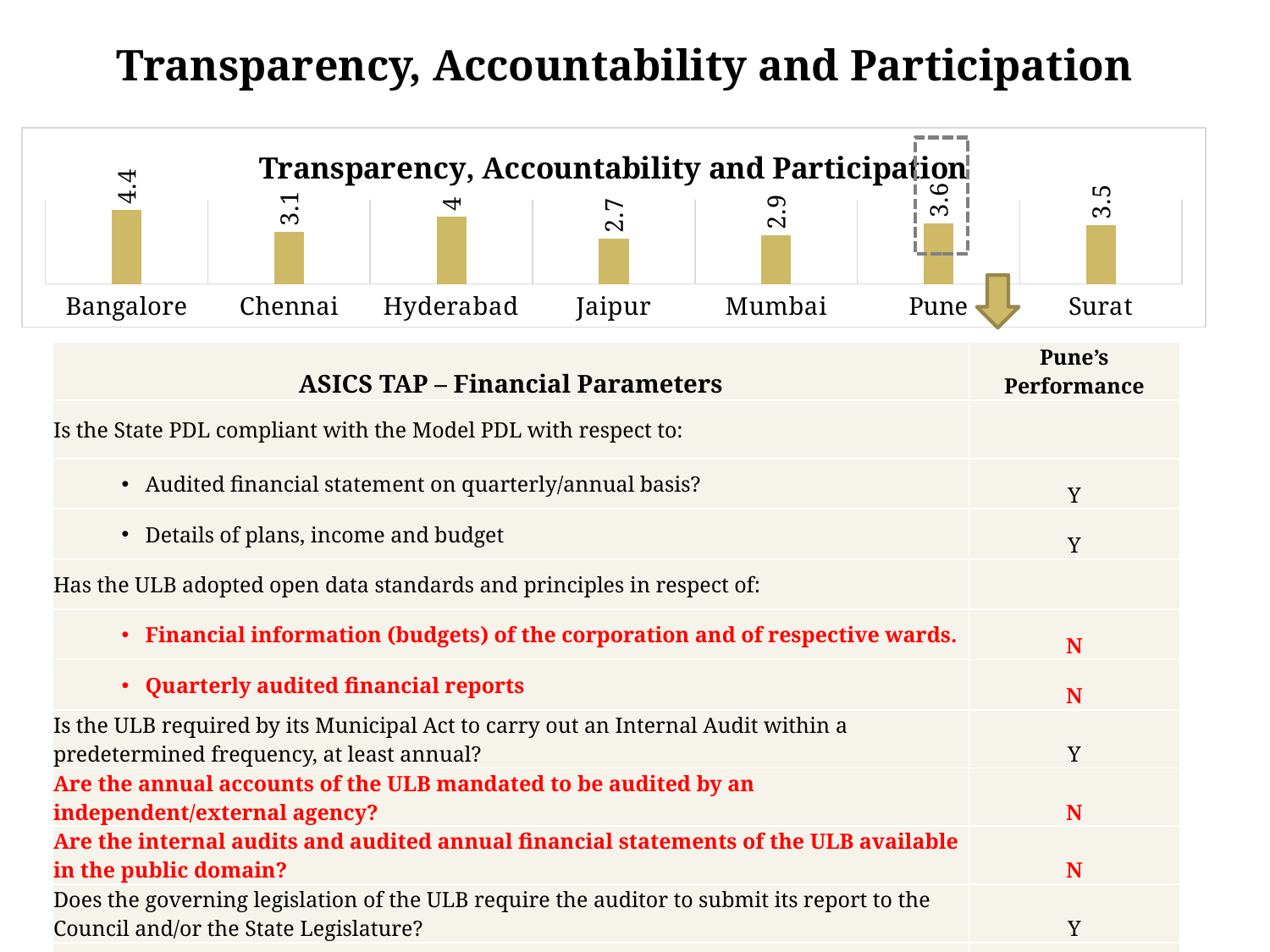
What kind of chart is shown on the slide? Bar chart What is the difference between the values for Bangalore and Jaipur? 1.7 Which city has the highest value in the chart? Bangalore Which city has the lowest value in the chart? Jaipur What is the value for Pune in the chart? 3.6 What is the value for Jaipur in the chart? 2.7 Which has a larger value, Pune or Mumbai? Pune What is the title of the chart? Transparency, Accountability and Participation Which has a larger value, Hyderabad or Surat? Hyderabad How many cities are shown in the chart? 7 What is the difference between the values for Hyderabad and Chennai? 0.9 What is the value for Bangalore in the chart? 4.4